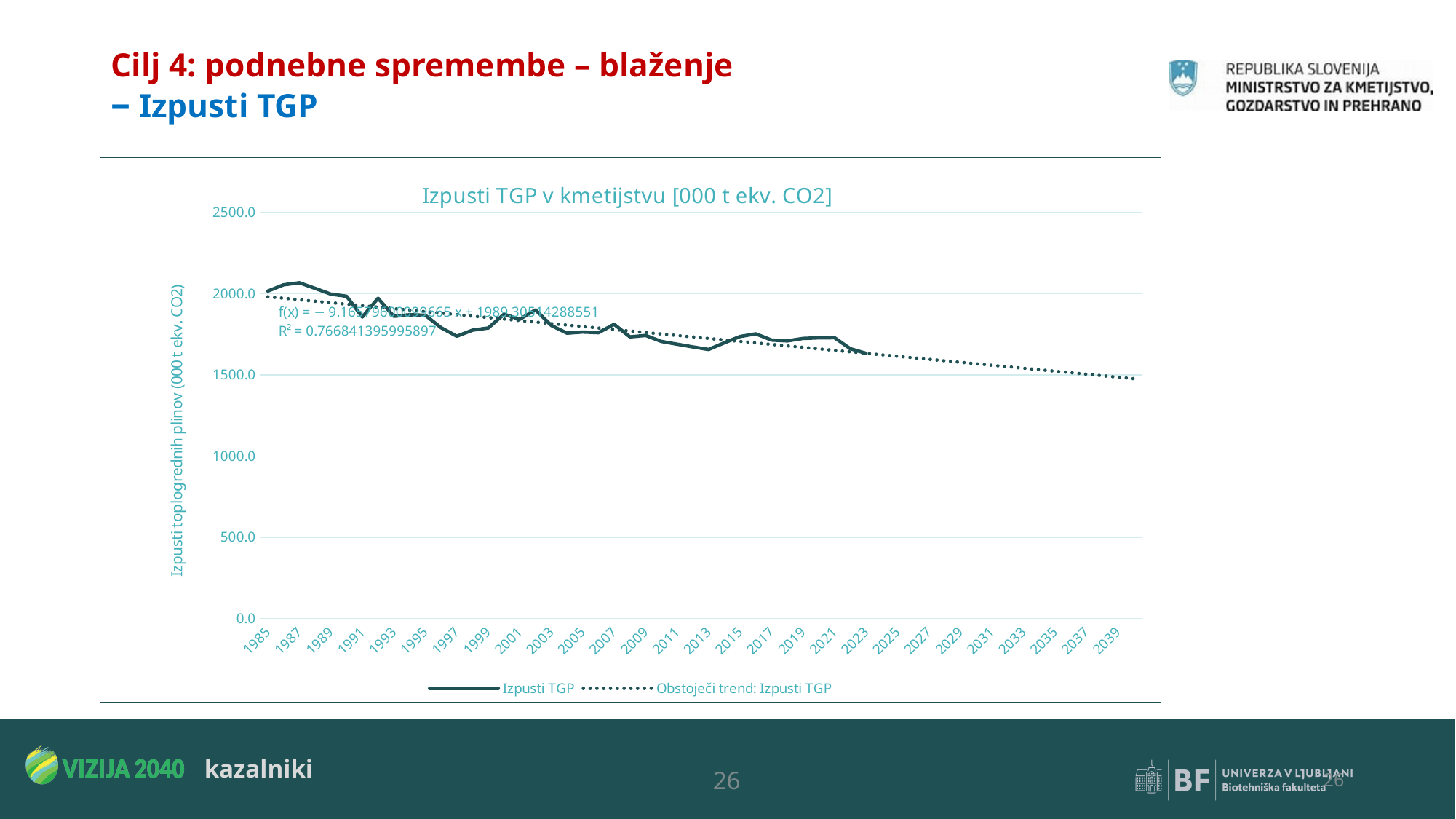
Is the Izpusti TGP value for 1987 greater or less than 2000? greater Is the Izpusti TGP value for 2013 greater or less than 2000? less Is the Izpusti TGP value for 2023 greater or less than 1500? greater What kind of chart is shown on the slide? line chart Which is larger, the Izpusti TGP value for 1987 or for 2023? 1987 In which year is the Izpusti TGP value highest? 1987 What is the title of the chart? Izpusti TGP v kmetijstvu [000 t ekv. CO2] Do the Izpusti TGP values generally rise or fall from 1985 to 2023? fall What R² value is printed on the chart? R² = 0.766841395995897 How many year labels are shown on the x axis? 28 How many series does the legend list? 2